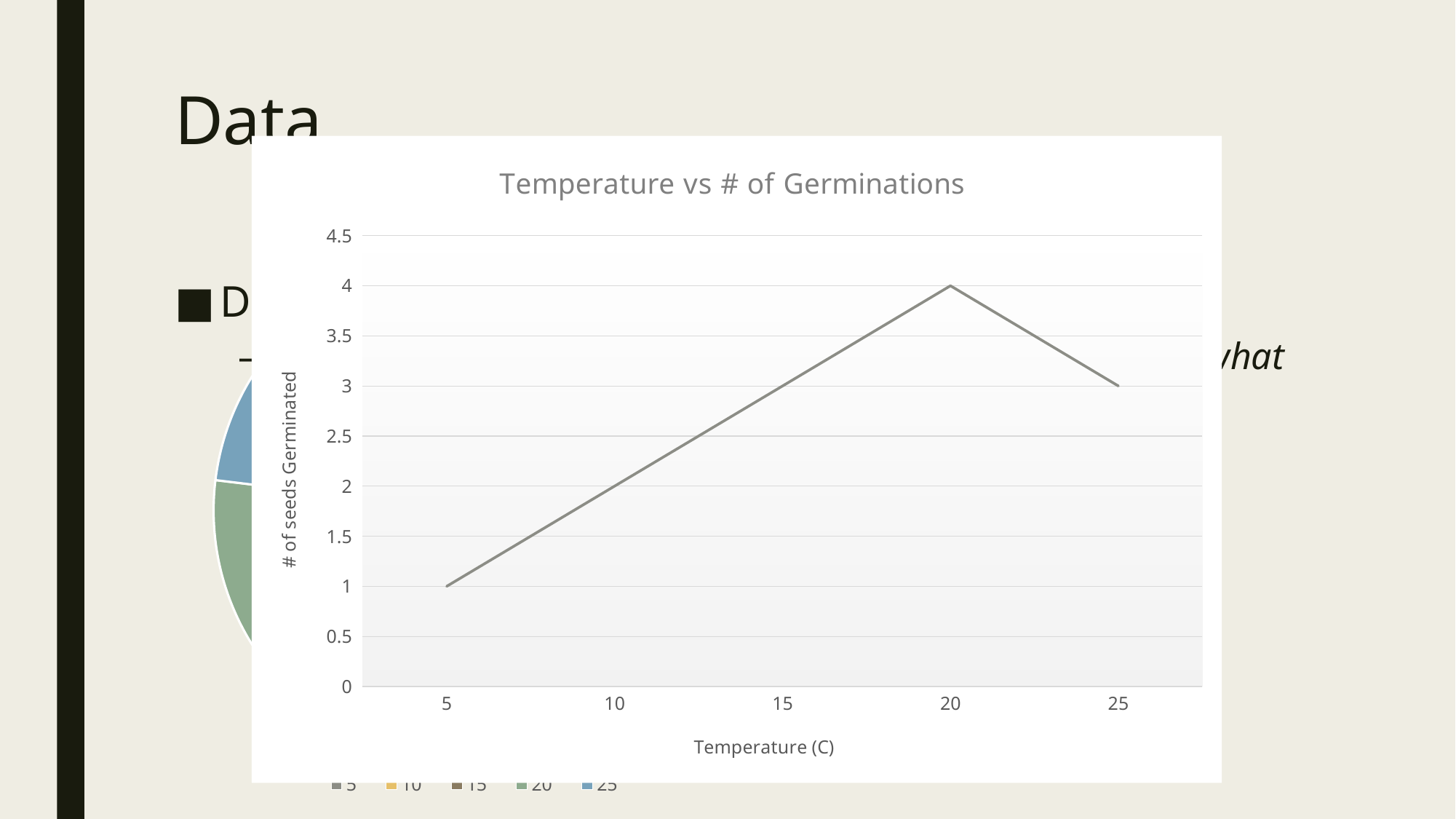
What kind of chart is "Temperature vs # of Germinations"? line chart How many temperature points are plotted in the "Temperature vs # of Germinations" chart? 5 In the "Temperature vs # of Germinations" chart, is the value at 15 C greater or less than 2.5? greater What is the x-axis title of the "Temperature vs # of Germinations" chart? Temperature (C) In the "Temperature vs # of Germinations" chart, what is the difference between the number of seeds germinated at 20 C and at 25 C? 1 In the "Temperature vs # of Germinations" chart, how many seeds germinated at 20 C? 4 In the "Temperature vs # of Germinations" chart, at which temperature is the number of seeds germinated highest? 20 In the "Temperature vs # of Germinations" chart, at which temperature is the number of seeds germinated lowest? 5 In the "Temperature vs # of Germinations" chart, which temperature has more seeds germinated, 10 C or 25 C? 25 In the "Temperature vs # of Germinations" chart, how many seeds germinated at 25 C? 3 In the "Temperature vs # of Germinations" chart, does the number of seeds germinated rise or fall from 5 C to 20 C? rise In the "Temperature vs # of Germinations" chart, how many seeds germinated at 5 C? 1